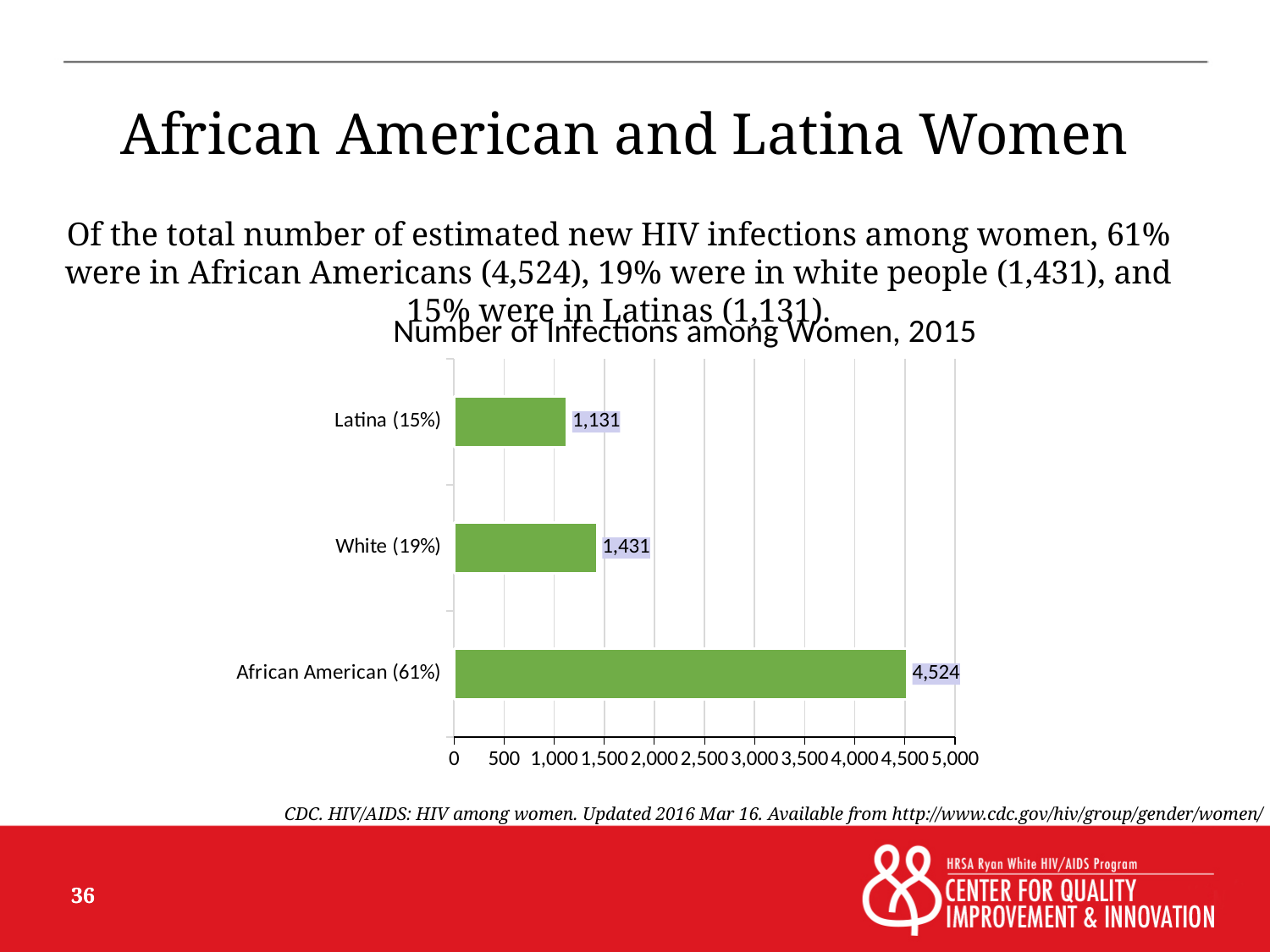
What is the number of infections among Latina women shown on the chart? 1,131 Which has more infections, White women or Latina women? White What is the number of infections among White women shown on the chart? 1,431 Which category has the highest number of infections? African American (61%) Which category has the lowest number of infections? Latina (15%) Is the value for African American women greater or less than 4,000? greater What type of chart is shown on the slide? Bar chart How many categories are shown on the chart? 3 What is the title of the chart? Number of Infections among Women, 2015 What is the difference in infections between African American and White women? 3,093 What is the number of infections among African American women shown on the chart? 4,524 What is the difference in infections between White and Latina women? 300